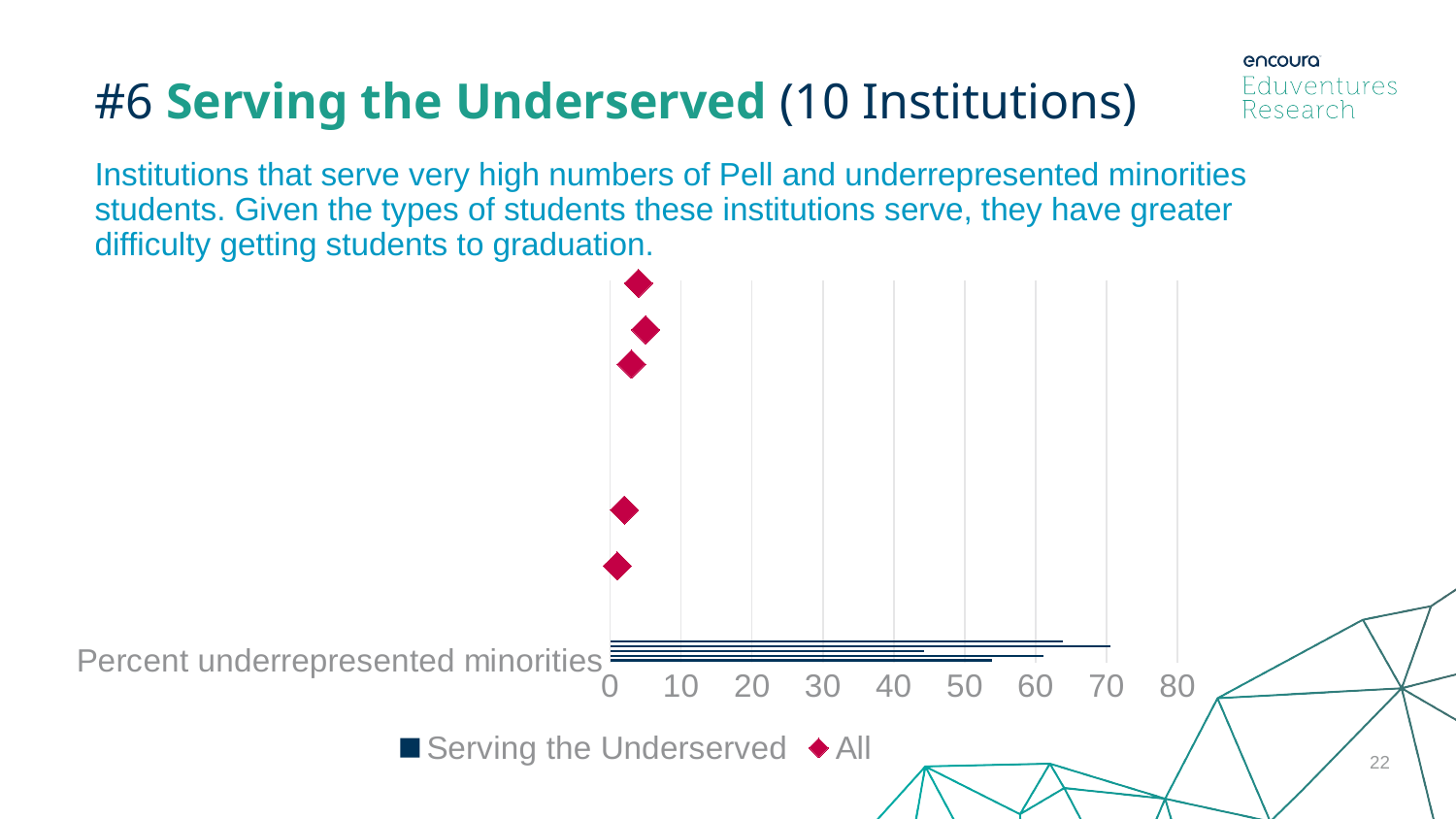
What kind of chart is shown on the slide? bar chart What are the two series named in the chart legend? Serving the Underserved and All Are the diamond markers for the All series greater or less than 10 on the x axis? less Which category label is readable on the chart's vertical axis? Percent underrepresented minorities For Percent underrepresented minorities, which series shows larger values: Serving the Underserved or All? Serving the Underserved How many series does the chart legend list? 2 Which series is shown with diamond markers in the chart? All Is the longest bar for Percent underrepresented minorities greater or less than 80? less Is the longest bar for Percent underrepresented minorities greater or less than 40? greater